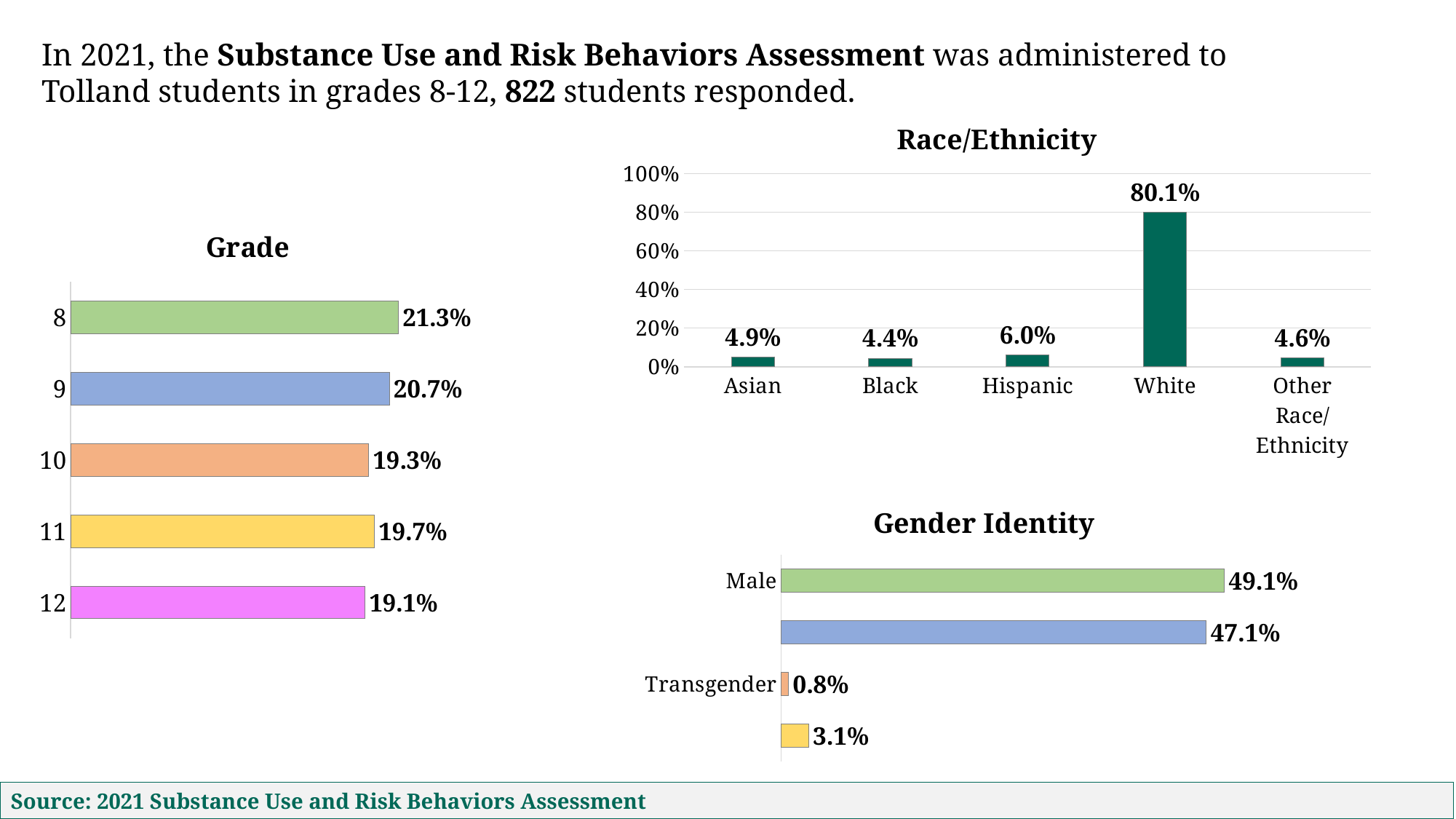
What type of chart is the Race/Ethnicity chart? Bar chart In the Race/Ethnicity chart, which category has the lowest percentage? Black In the Grade chart, what percentage of respondents were in grade 8? 21.3% In the Grade chart, which grade has the lowest percentage of respondents? 12 In the Race/Ethnicity chart, which category has the highest percentage? White In the Grade chart, what is the difference between the percentages for grade 9 and grade 10? 1.4% In the Race/Ethnicity chart, what is the difference between the White and Hispanic percentages? 74.1% In the Race/Ethnicity chart, is the value for Asian larger than the value for Other Race/Ethnicity? Yes In the Race/Ethnicity chart, what percentage of respondents were Hispanic? 6.0% In the Gender Identity chart, what is the difference between the Male bar and the bar directly below it? 2.0% In the Gender Identity chart, what percentage of respondents identified as Transgender? 0.8% In the Grade chart, how many grade categories are shown? 5